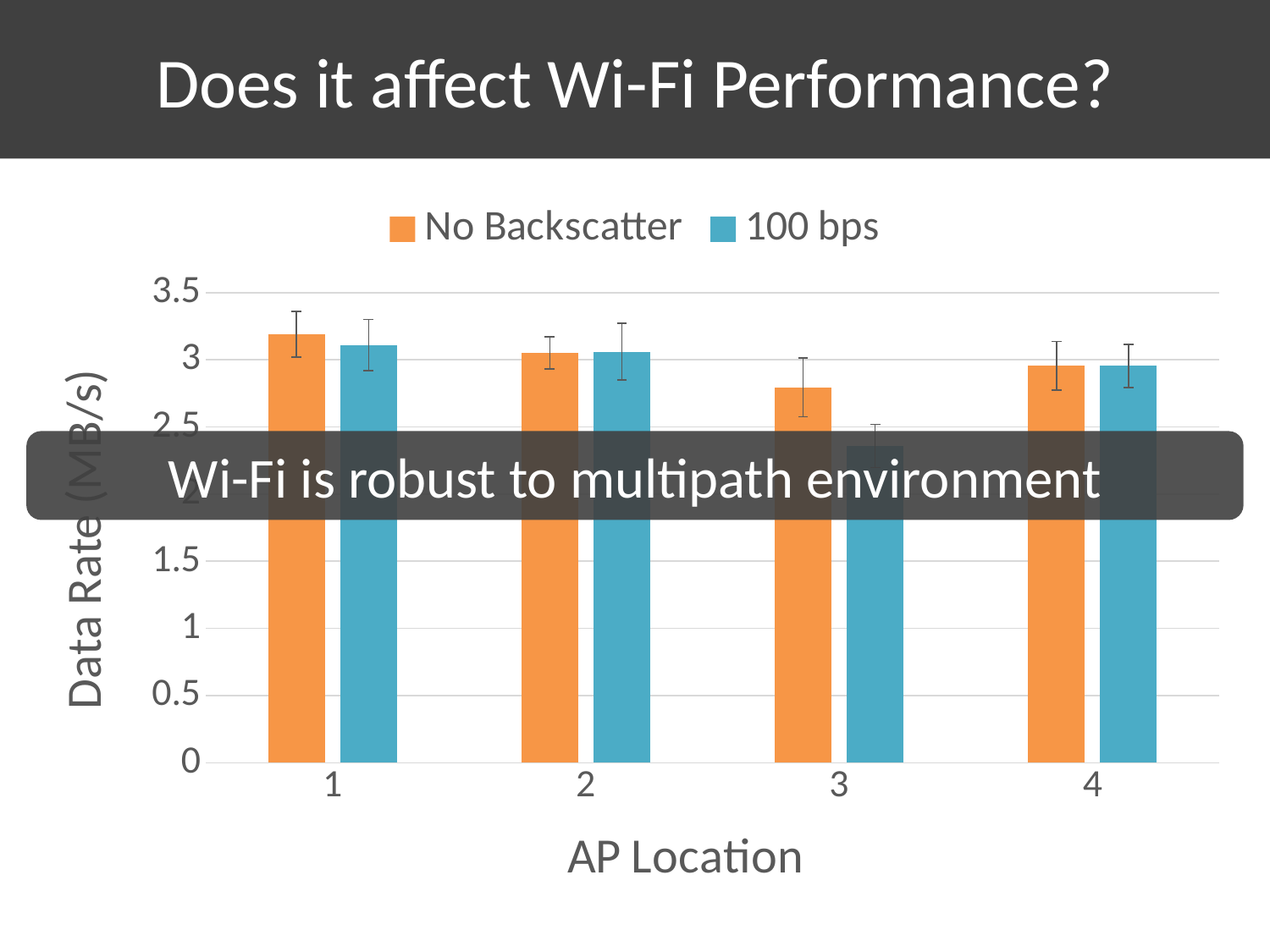
At AP location 3, which is larger: the No Backscatter value or the 100 bps value? No Backscatter What are the two series named in the legend? No Backscatter and 100 bps Is the 100 bps value at AP location 3 greater or less than 2.5? less What is the label of the y axis? Data Rate (MB/s) Is the No Backscatter value at AP location 3 greater or less than 3? less Which AP location has the lowest 100 bps data rate? 3 How many AP locations are shown on the x axis? 4 Is the 100 bps value at AP location 1 greater or less than 3? greater How many series does the legend list? 2 Which AP location has the highest No Backscatter data rate? 1 What kind of chart is shown on the slide? bar chart